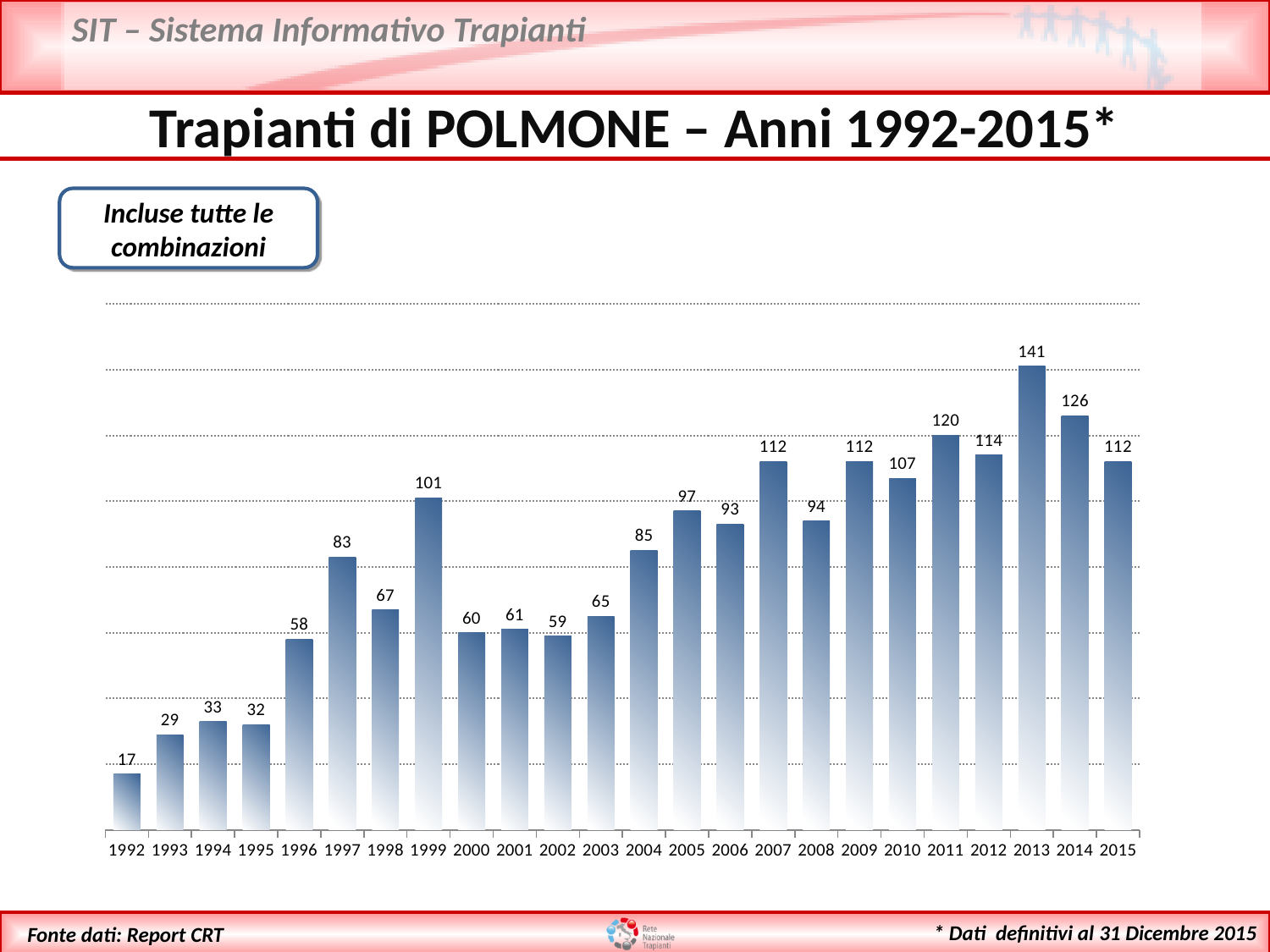
What is the value for 1992? 17 What kind of chart is shown on the slide? bar chart What is the difference between the values for 2013 and 1992? 124 Which is larger, the value for 1997 or the value for 1998? 1997 Do the values generally rise or fall from 1992 to 2013? rise How many years are shown on the x axis? 24 What is the title of the chart? Trapianti di POLMONE – Anni 1992-2015* Which year has the lowest value? 1992 Which year has the highest value? 2013 What is the value for 1999? 101 What is the value for 2013? 141 What is the difference between the values for 2014 and 2015? 14